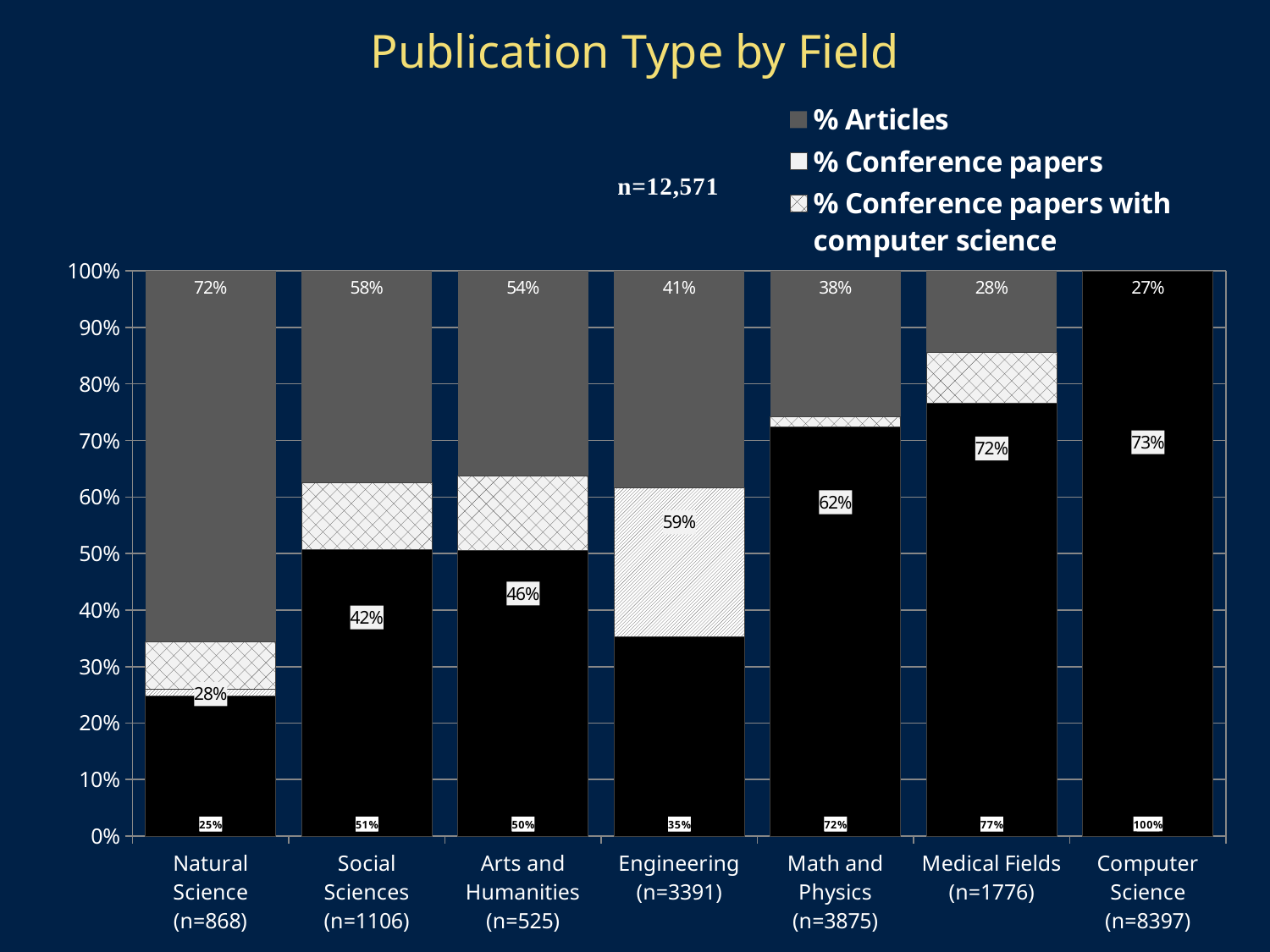
Which field has the highest % Articles? Natural Science What is the % Articles value for Computer Science? 27% What total sample size (n) is stated on the slide? n=12,571 What kind of chart is shown on the slide? Stacked bar chart How many series does the legend list? 3 What is the % Articles value for Natural Science? 72% Does the % Articles value rise or fall moving from left to right across the fields? Falls How many fields (categories) are shown along the x axis? 7 What is the difference in % Articles between Natural Science and Engineering? 31 percentage points Which has a larger % Articles value, Social Sciences or Arts and Humanities? Social Sciences Which field has the lowest % Articles? Computer Science What is the % Articles value for Engineering? 41%